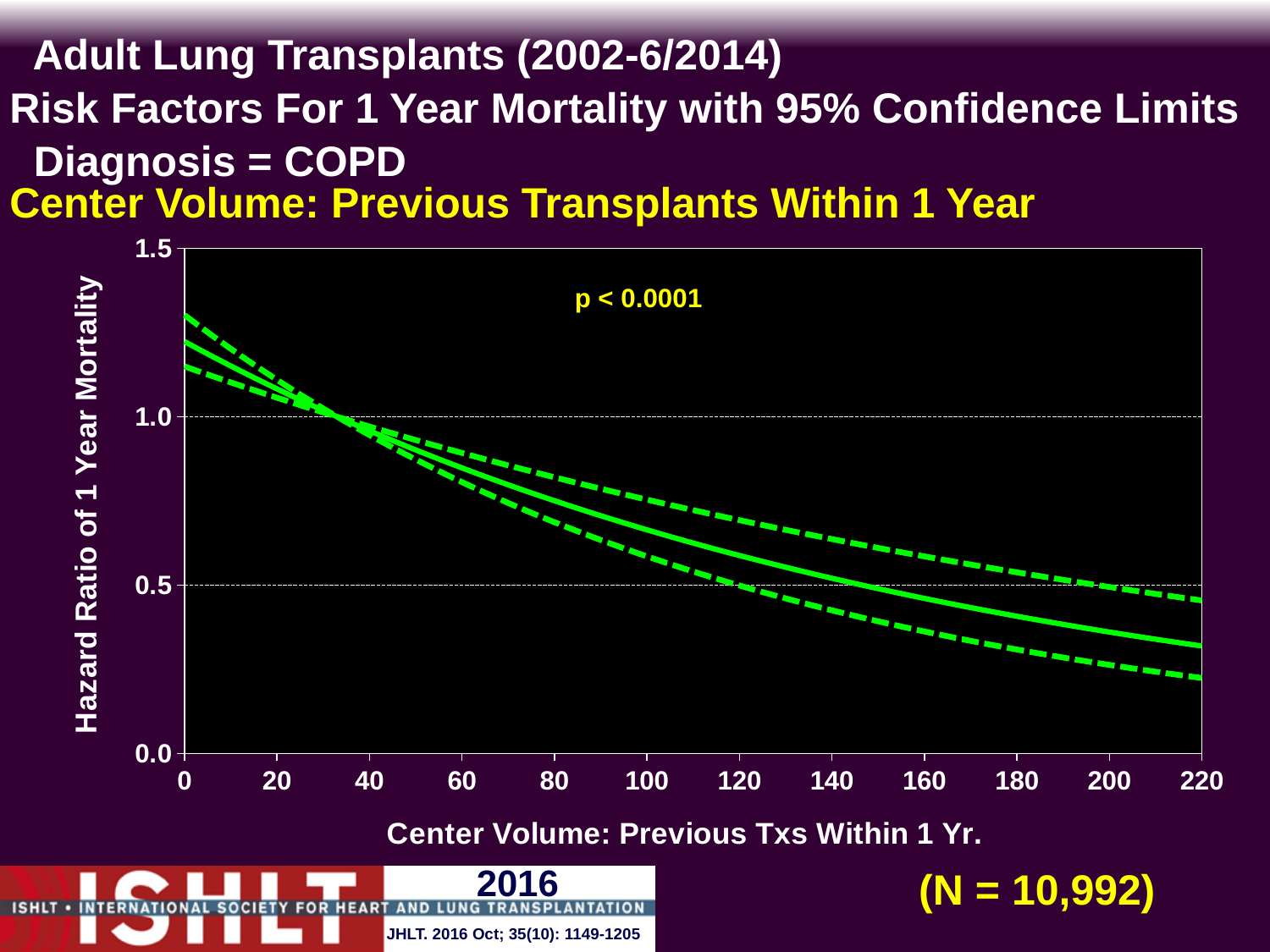
Is the hazard ratio on the solid line at a center volume of 100 greater or less than 0.5? greater What is the highest value shown on the x axis? 220 Is the upper dashed confidence limit at a center volume of 0 greater or less than 1.0? greater What p-value is printed on the chart? p < 0.0001 What kind of chart is shown on the slide? Line chart Is the hazard ratio on the solid line at a center volume of 220 greater or less than 0.5? less How many lines are plotted on the chart? 3 Does the hazard ratio of 1 year mortality rise or fall as center volume increases along the x axis? Fall